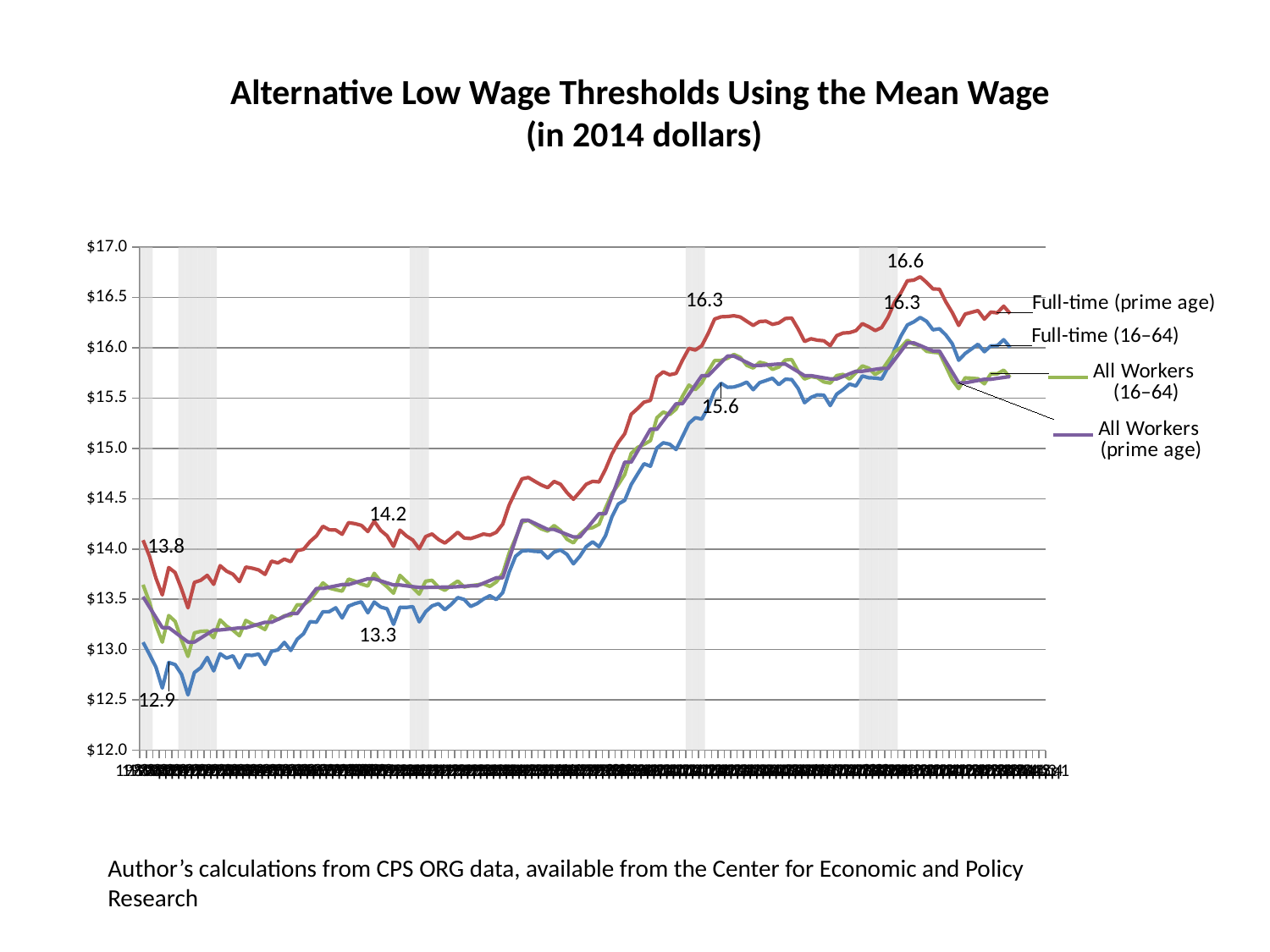
Which series is the lowest line at the left end of the chart? Full-time (16–64) How many series does the legend list? 4 What is the difference between the highest data label (16.6) and the lowest data label (12.9) on the chart? 3.7 What kind of chart is shown on the slide? line chart Which series is the highest line across the chart? Full-time (prime age) Overall, do the lines rise or fall from left to right along the x axis? rise Is the value of the Full-time (16–64) line at the left end of the chart greater or less than $13.5? less What is the title of the chart? Alternative Low Wage Thresholds Using the Mean Wage (in 2014 dollars) Is the value of the Full-time (prime age) line at the right end of the chart greater or less than $16.0? greater Which line is higher at the right end of the chart, Full-time (prime age) or All Workers (prime age)? Full-time (prime age) What is the lowest data label printed on the chart? 12.9 What is the highest data label printed on the chart? 16.6